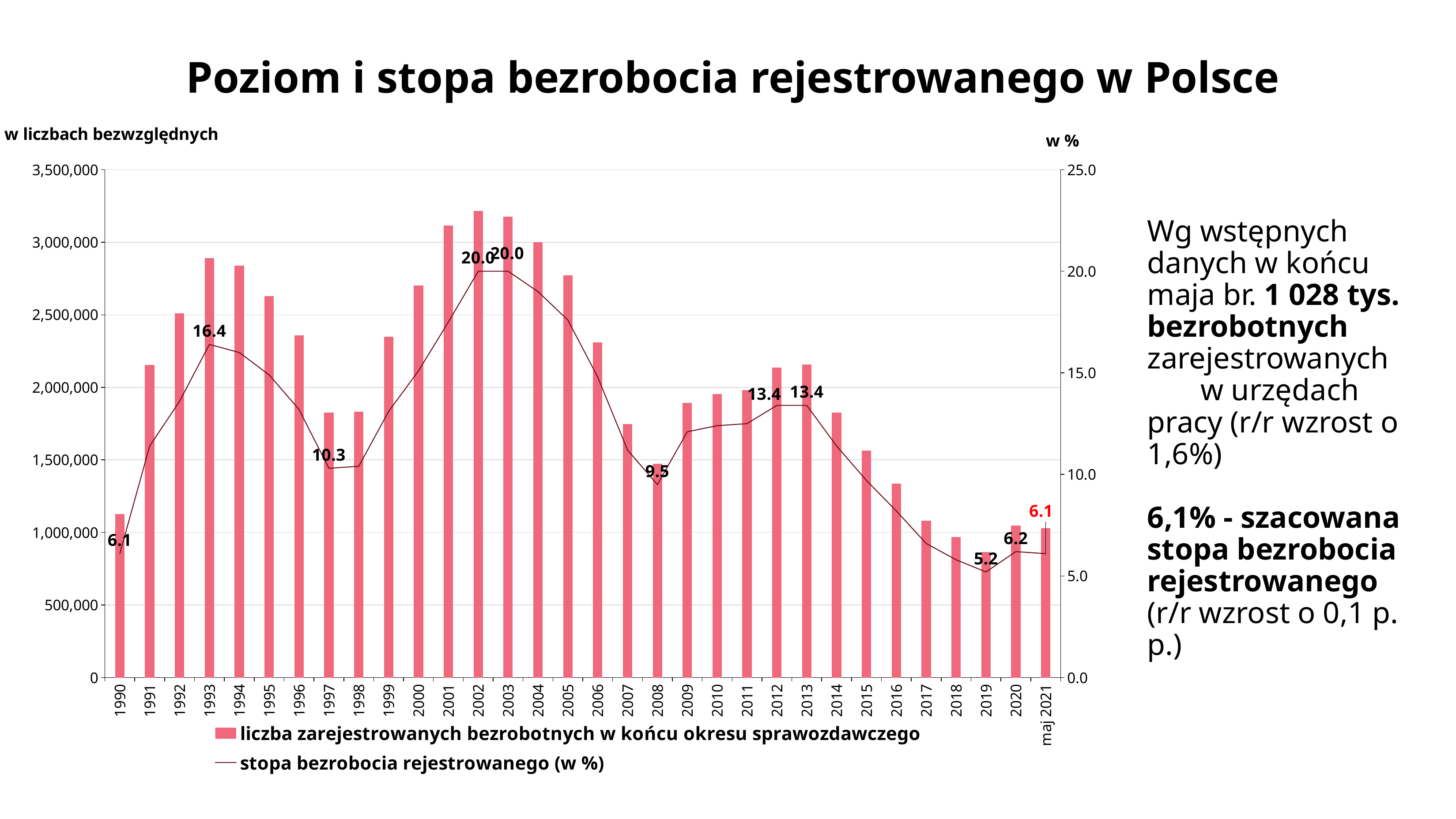
Is the number of registered unemployed in 2001 greater or less than 3,000,000? greater Is the number of registered unemployed in 2018 greater or less than 1,000,000? less Does the unemployment rate line rise or fall between 2013 and 2019? fall What is the registered unemployment rate shown for maj 2021? 6.1 What is the difference between the unemployment rate in 2003 (20.0) and in 2008 (9.5)? 10.5 In which year does the registered unemployment rate line reach its lowest value? 2019 What is the registered unemployment rate shown for 2008? 9.5 Which year has the lowest bar for the number of registered unemployed? 2019 Which year has the higher unemployment rate, 1993 or 2012? 1993 What is the registered unemployment rate (stopa bezrobocia rejestrowanego) shown for 1993? 16.4 What is the difference between the unemployment rate in 1993 (16.4) and in 1997 (10.3)? 6.1 How many series does the legend list? 2